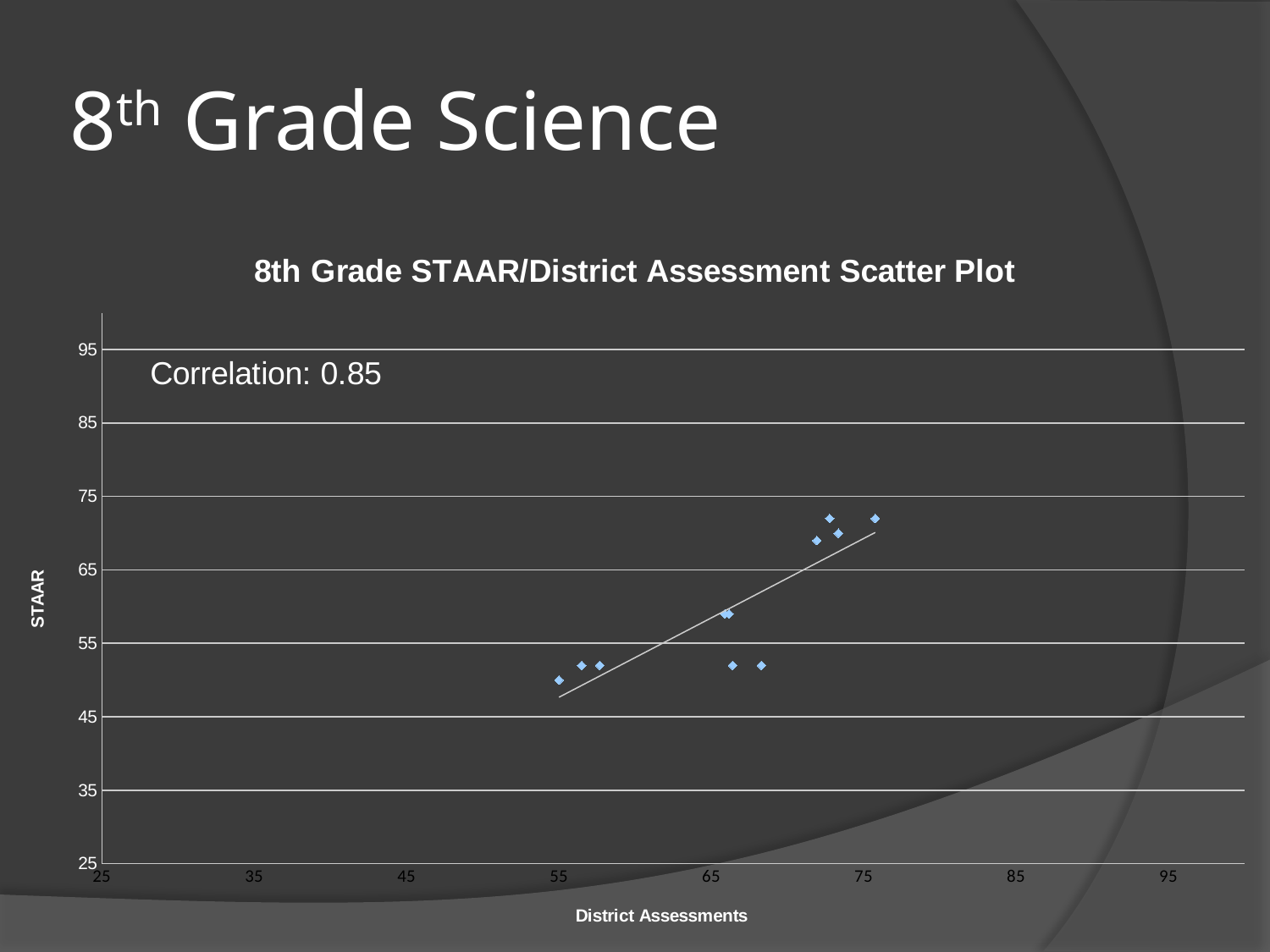
What kind of chart is shown on the slide? scatter plot What is the title of the chart? 8th Grade STAAR/District Assessment Scatter Plot Is the STAAR value for the point with the highest District Assessment score greater or less than 65? greater Is the lowest STAAR value plotted greater or less than 45? greater What is the highest tick value shown on the horizontal axis? 95 Is the STAAR value for the point with the lowest District Assessment score greater or less than 55? less Do the STAAR values generally rise or fall as District Assessment scores increase? rise What correlation value is printed on the chart? 0.85